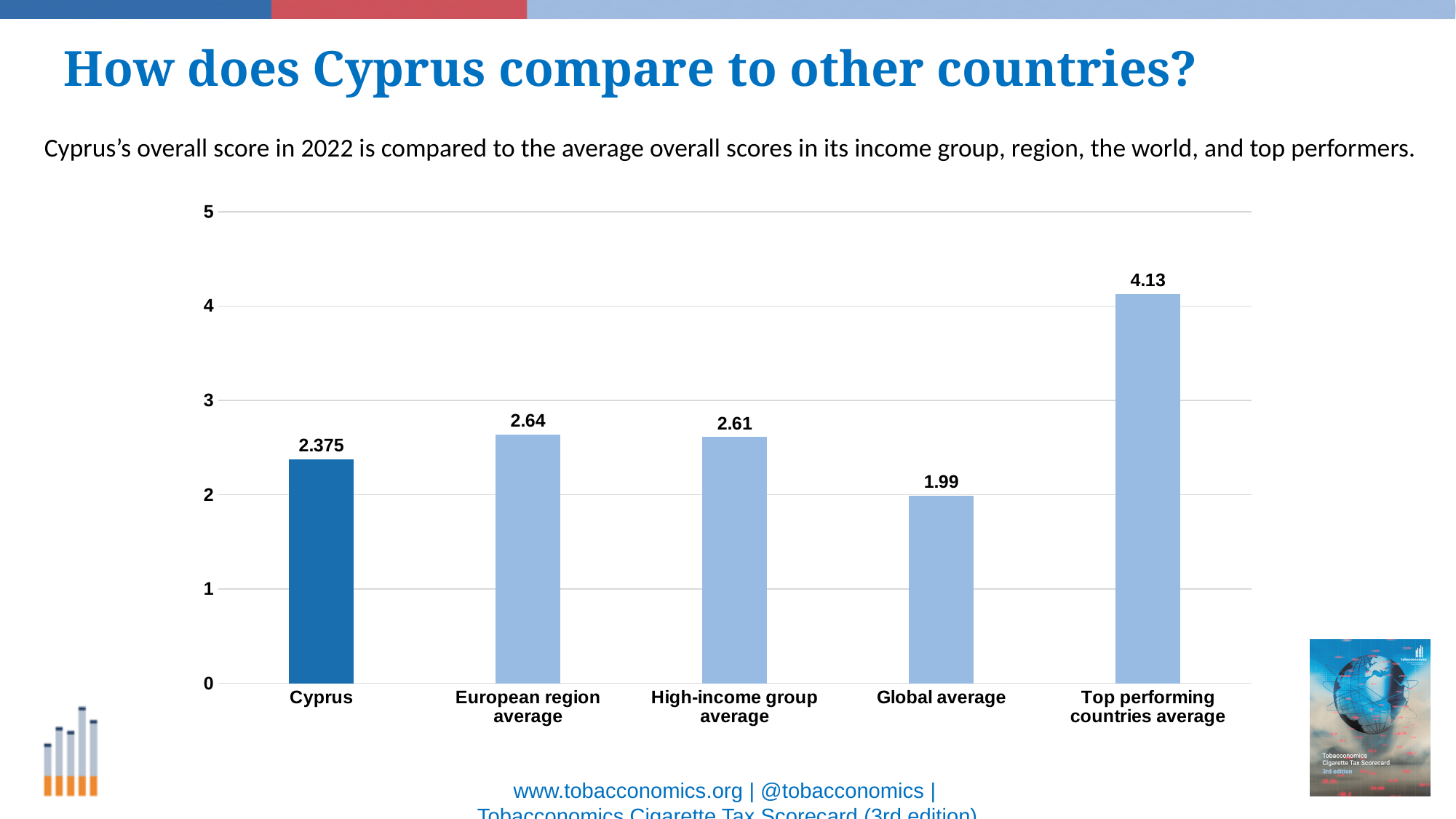
Which is larger, the value for Cyprus or the Global average? Cyprus Is the value for the High-income group average greater or less than 3? less Which bar is shown in a darker blue than the others? Cyprus What is the value for Cyprus? 2.375 How many categories are shown on the chart? 5 Which category has the lowest value? Global average What is the difference between the Top performing countries average and Cyprus? 1.755 What kind of chart is shown on the slide? bar chart Which category has the highest value? Top performing countries average What is the value for the Global average? 1.99 What is the value for the European region average? 2.64 What is the value for the Top performing countries average? 4.13